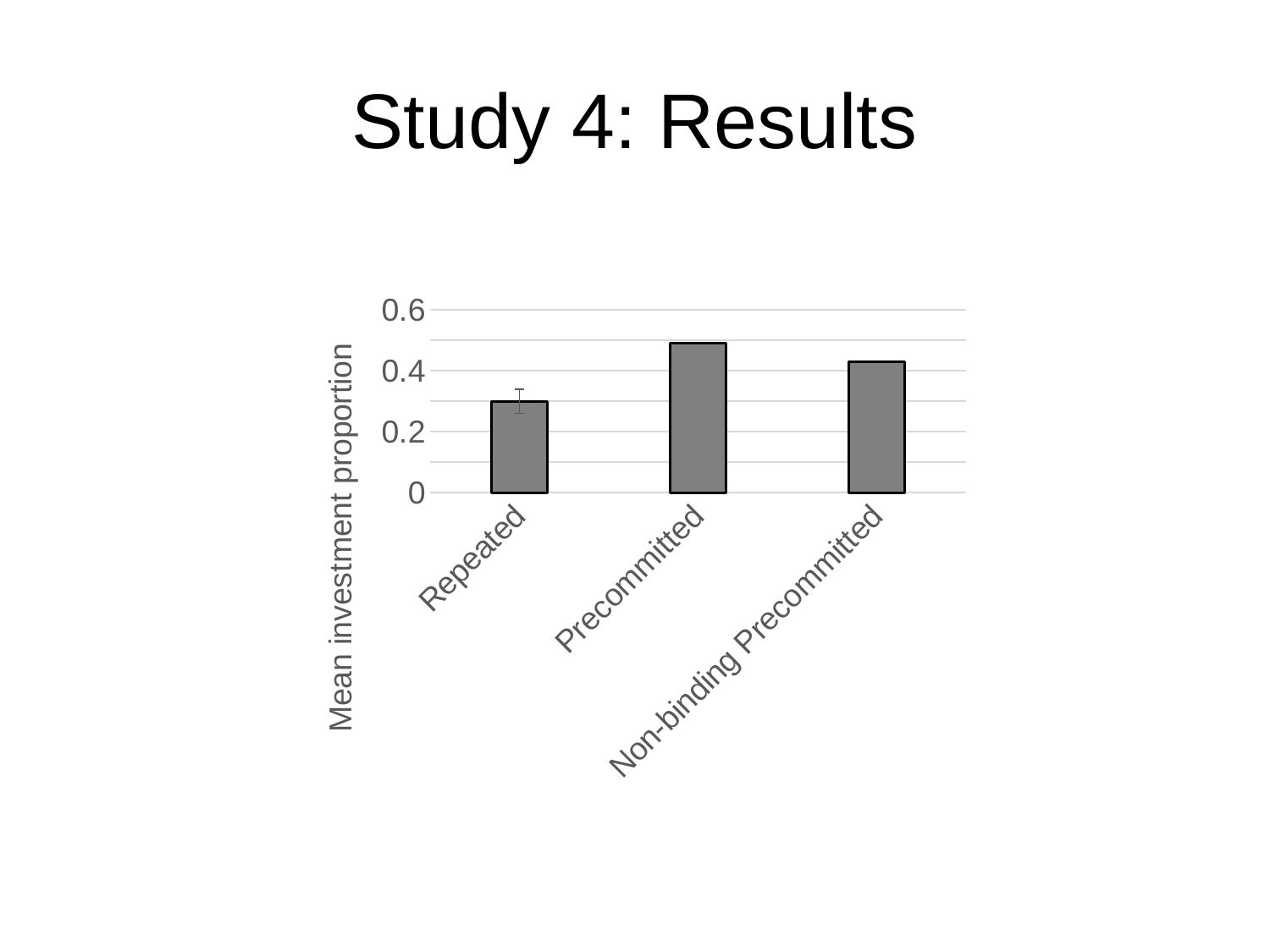
Which category has the highest mean investment proportion? Precommitted Is the value for Precommitted greater or less than 0.4? greater Which is larger, the value for Precommitted or the value for Non-binding Precommitted? Precommitted Is the value for Non-binding Precommitted greater or less than 0.4? greater What kind of chart is shown on the slide? bar chart How many categories are plotted on the x axis? 3 Is the value for Repeated greater or less than 0.4? less Which is larger, the value for Repeated or the value for Non-binding Precommitted? Non-binding Precommitted Which category has the lowest mean investment proportion? Repeated What is the label on the vertical axis of the chart? Mean investment proportion